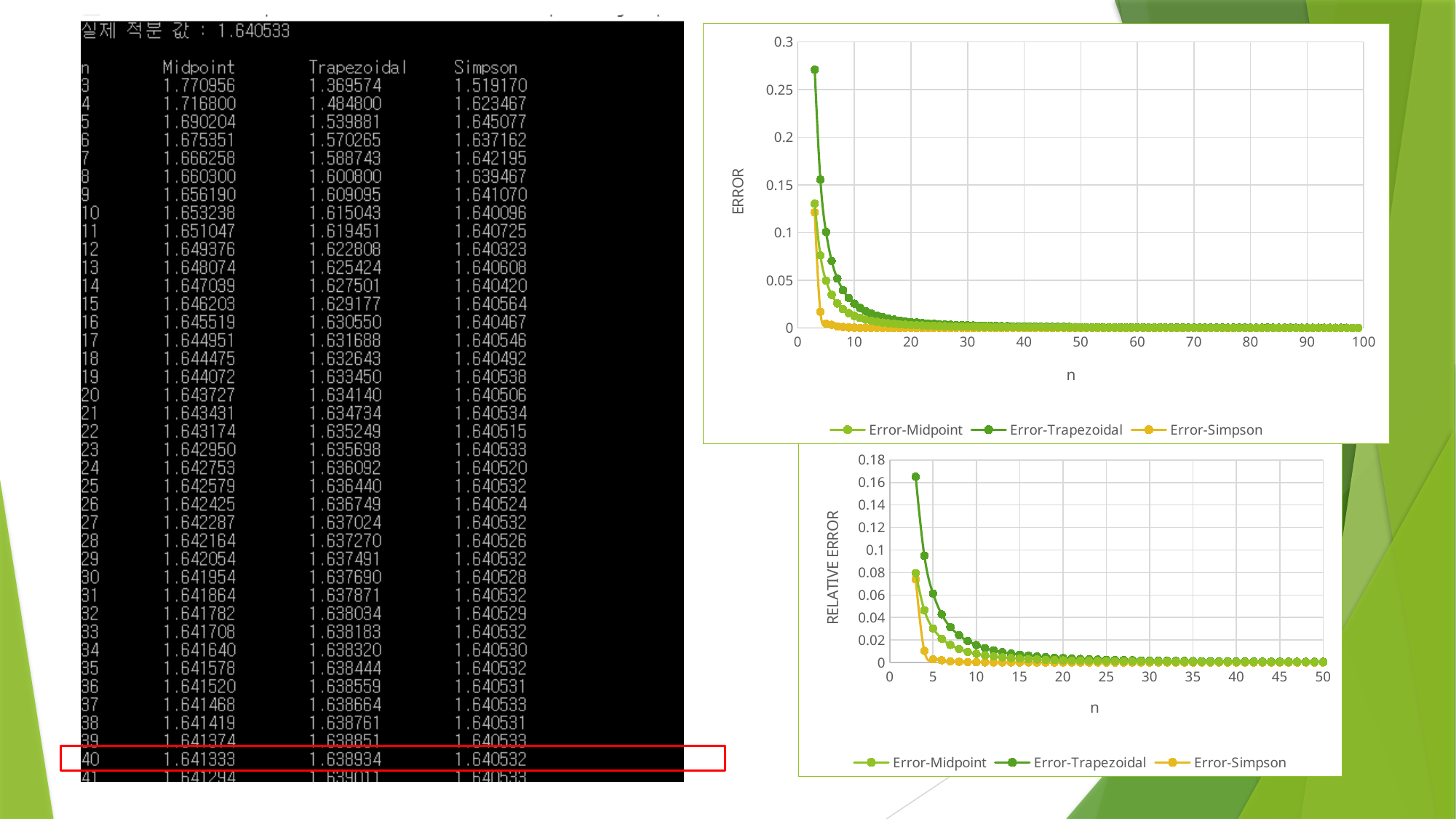
What kind of chart is the top chart with the y-axis labelled ERROR? line chart What is the x-axis title of the bottom RELATIVE ERROR chart? n In the bottom RELATIVE ERROR chart, is the value of Error-Midpoint at n = 3 greater or less than 0.06? greater What is the y-axis title of the bottom chart? RELATIVE ERROR In the bottom RELATIVE ERROR chart, is the value of Error-Trapezoidal at n = 3 greater or less than 0.14? greater In the top ERROR chart, is the value of Error-Trapezoidal at n = 3 greater or less than 0.25? greater How many series does the legend of the top ERROR chart list? 3 In the top ERROR chart, which series has the highest error at n = 3? Error-Trapezoidal In the top ERROR chart, do the error values rise or fall as n increases? fall In the top ERROR chart, which is larger at n = 5: Error-Trapezoidal or Error-Simpson? Error-Trapezoidal In the bottom RELATIVE ERROR chart, which series has the lowest relative error at n = 5? Error-Simpson